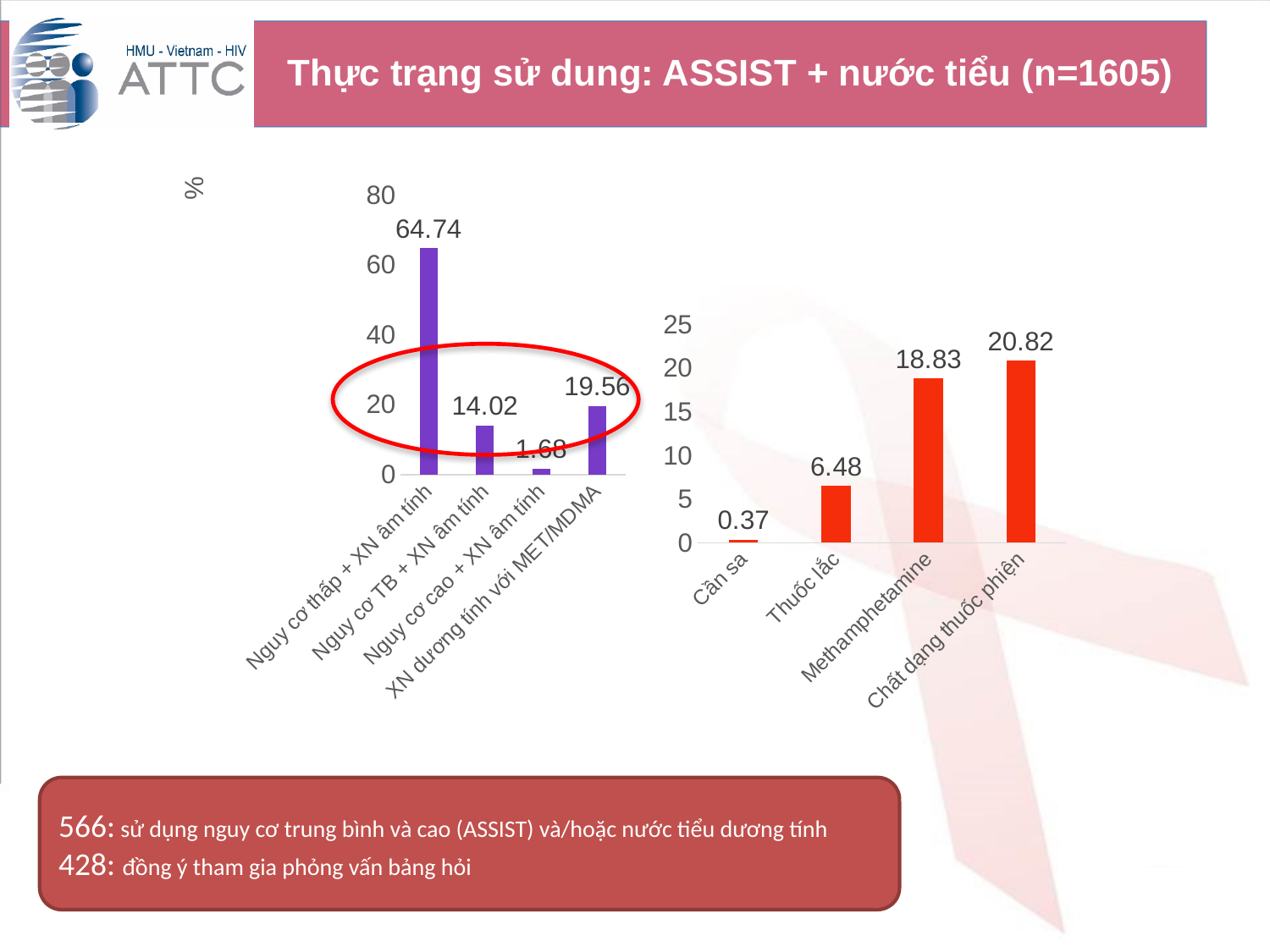
In the right chart, which category has the highest value? Chất dạng thuốc phiện In the right chart, which is larger, Thuốc lắc or Methamphetamine? Methamphetamine In the left chart, what is the value for "XN dương tính với MET/MDMA"? 19.56 In the left chart, which category has the lowest value? Nguy cơ cao + XN âm tính In the left chart, what is the value for "Nguy cơ thấp + XN âm tính"? 64.74 In the left chart, what is the difference between "Nguy cơ thấp + XN âm tính" and "Nguy cơ TB + XN âm tính"? 50.72 What kind of chart is the right chart? bar chart In the right chart, what is the value for Methamphetamine? 18.83 In the right chart, what is the difference between Chất dạng thuốc phiện and Thuốc lắc? 14.34 In the right chart, what is the value for Cần sa? 0.37 In the left chart, how many categories are shown? 4 In the right chart, do the values rise or fall from left to right along the x axis? rise